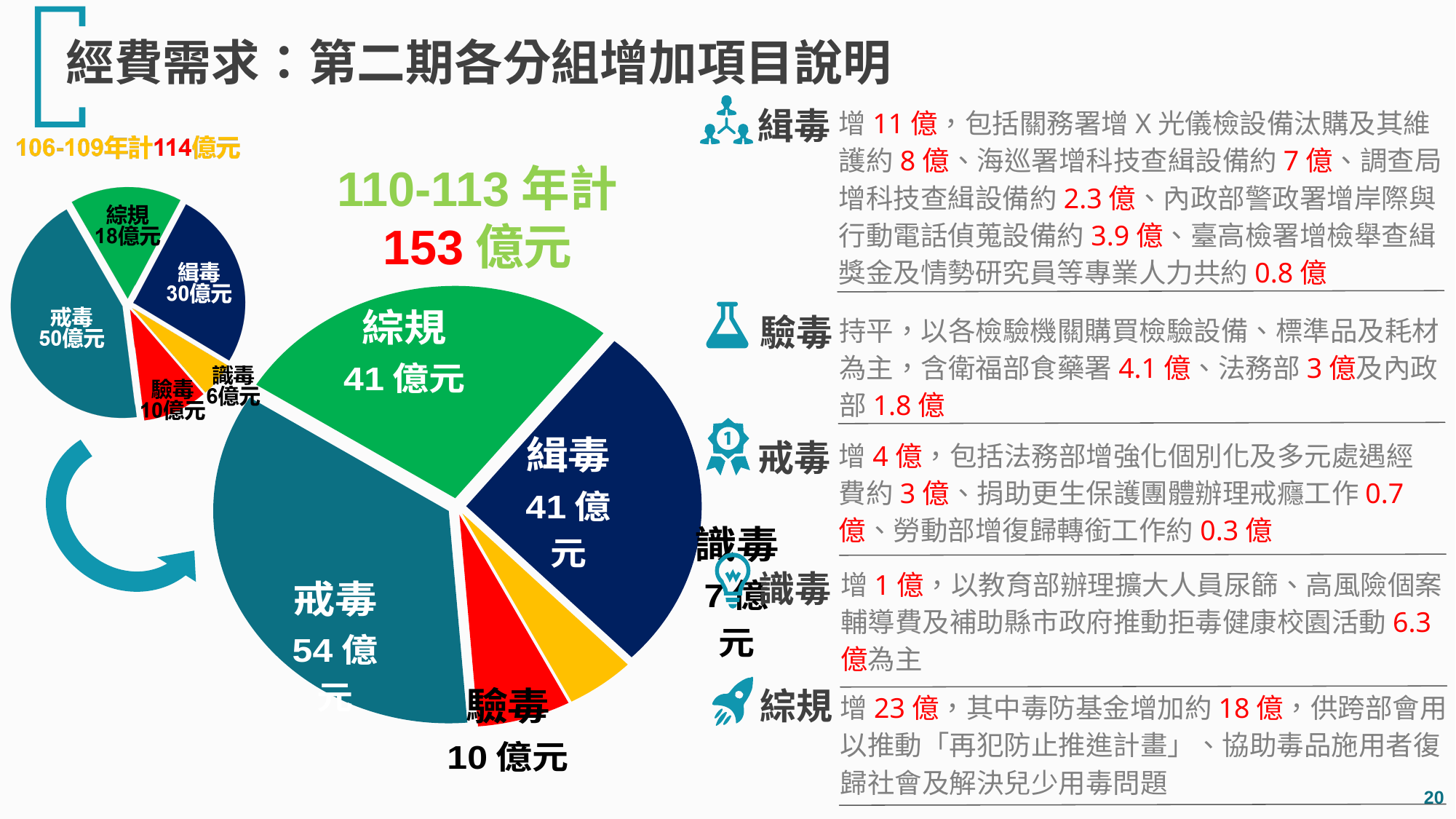
In the large pie chart (110-113 年計 153 億元), which category has the largest value? 戒毒 In the small pie chart (106-109年計114億元), what is the value for 緝毒? 30億元 In the small pie chart (106-109年計114億元), which is larger, 綜規 or 驗毒? 綜規 In the large pie chart (110-113 年計 153 億元), what is the difference between 戒毒 and 綜規? 13 億元 In the large pie chart (110-113 年計 153 億元), what is the value for 戒毒? 54 億元 How many slices does the large pie chart (110-113 年計 153 億元) have? 5 What is the total shown for the small pie chart covering 106-109年? 114億元 In the small pie chart (106-109年計114億元), which category has the smallest value? 識毒 In the large pie chart (110-113 年計 153 億元), what is the value for 識毒? 7 億元 In the small pie chart (106-109年計114億元), what is the difference between 戒毒 and 緝毒? 20億元 What type of chart is used to show the 110-113 年計 153 億元 breakdown? Pie chart